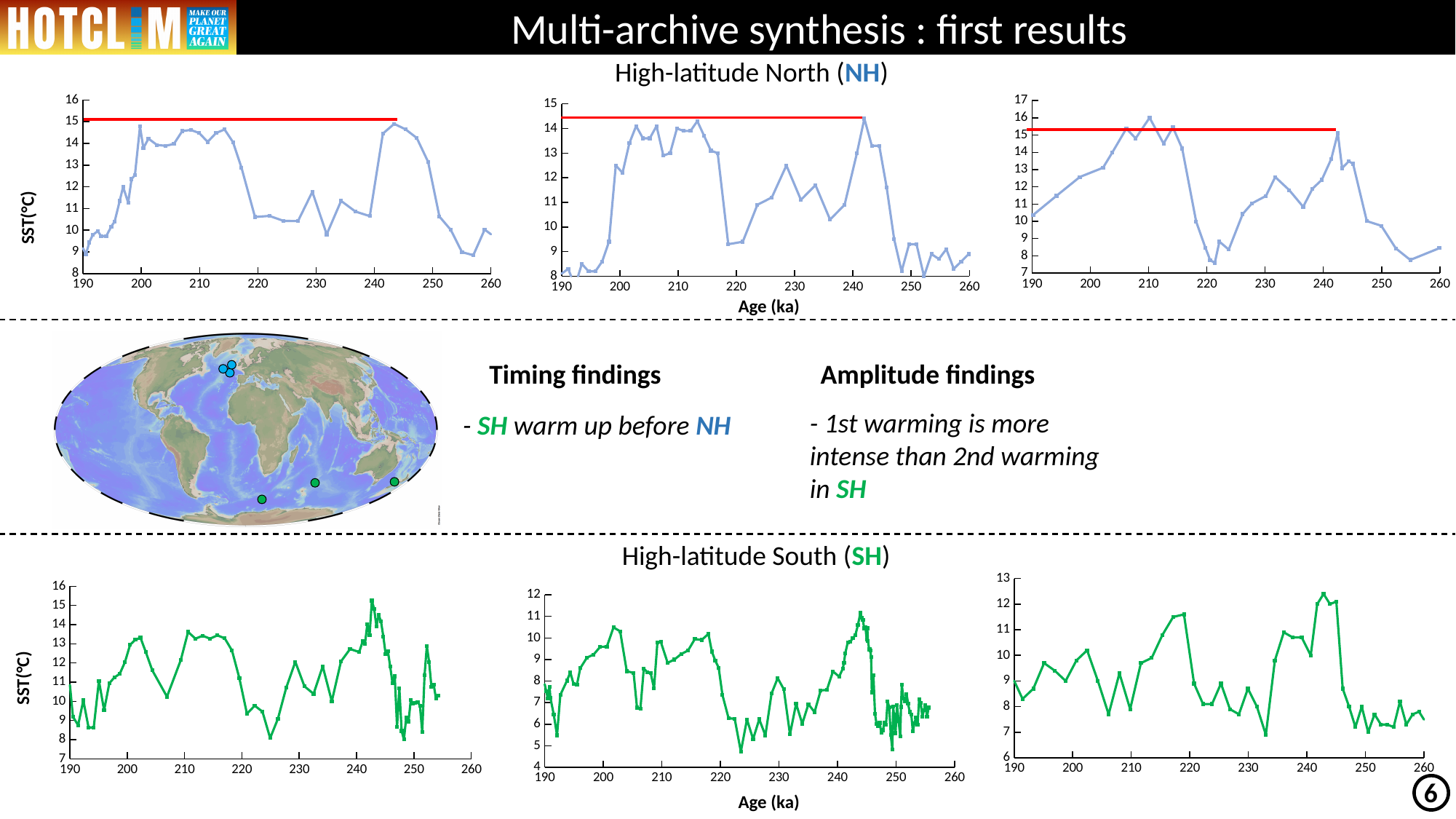
What kind of chart is the top-left High-latitude North (NH) chart? line chart In the bottom-middle High-latitude South (SH) chart, is the lowest SST value (near 223 ka) greater or less than 6? less In the top-right High-latitude North (NH) chart, is the SST value at 210 ka greater or less than 15? greater What is the x-axis label shared by the charts on the slide? Age (ka) In the top-left High-latitude North (NH) chart, is the SST value at 190 ka greater or less than 10? less How many charts are shown on the slide in total? 6 In the top-left High-latitude North (NH) chart, does the SST rise or fall between 190 ka and 200 ka? rise What colour are the lines in the High-latitude South (SH) charts? green In the bottom-right High-latitude South (SH) chart, does the SST rise or fall between 245 ka and 250 ka? fall